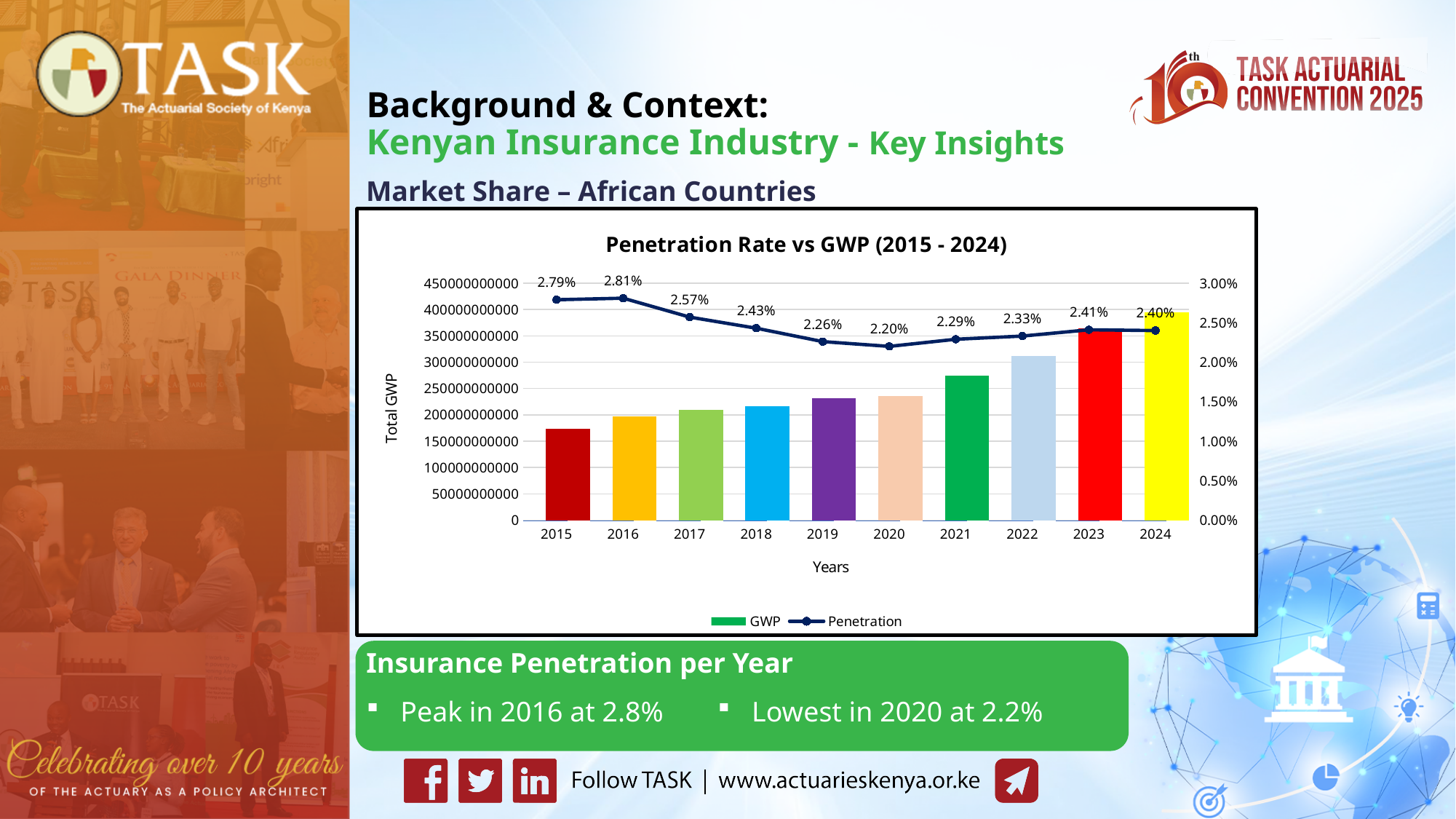
What is the penetration rate for 2020? 2.20% Is the Total GWP value for 2015 greater or less than 200000000000? less Which year has the highest Total GWP bar? 2024 Which year has the highest penetration rate? 2016 Is the Total GWP value for 2023 greater or less than 350000000000? greater What is the difference between the penetration rate in 2015 and in 2019? 0.53% How many series does the legend list? 2 Which year has the lowest penetration rate? 2020 Which year has the larger penetration rate, 2017 or 2022? 2017 What is the penetration rate for 2023? 2.41% What is the penetration rate for 2016? 2.81% How many years are shown on the x axis? 10